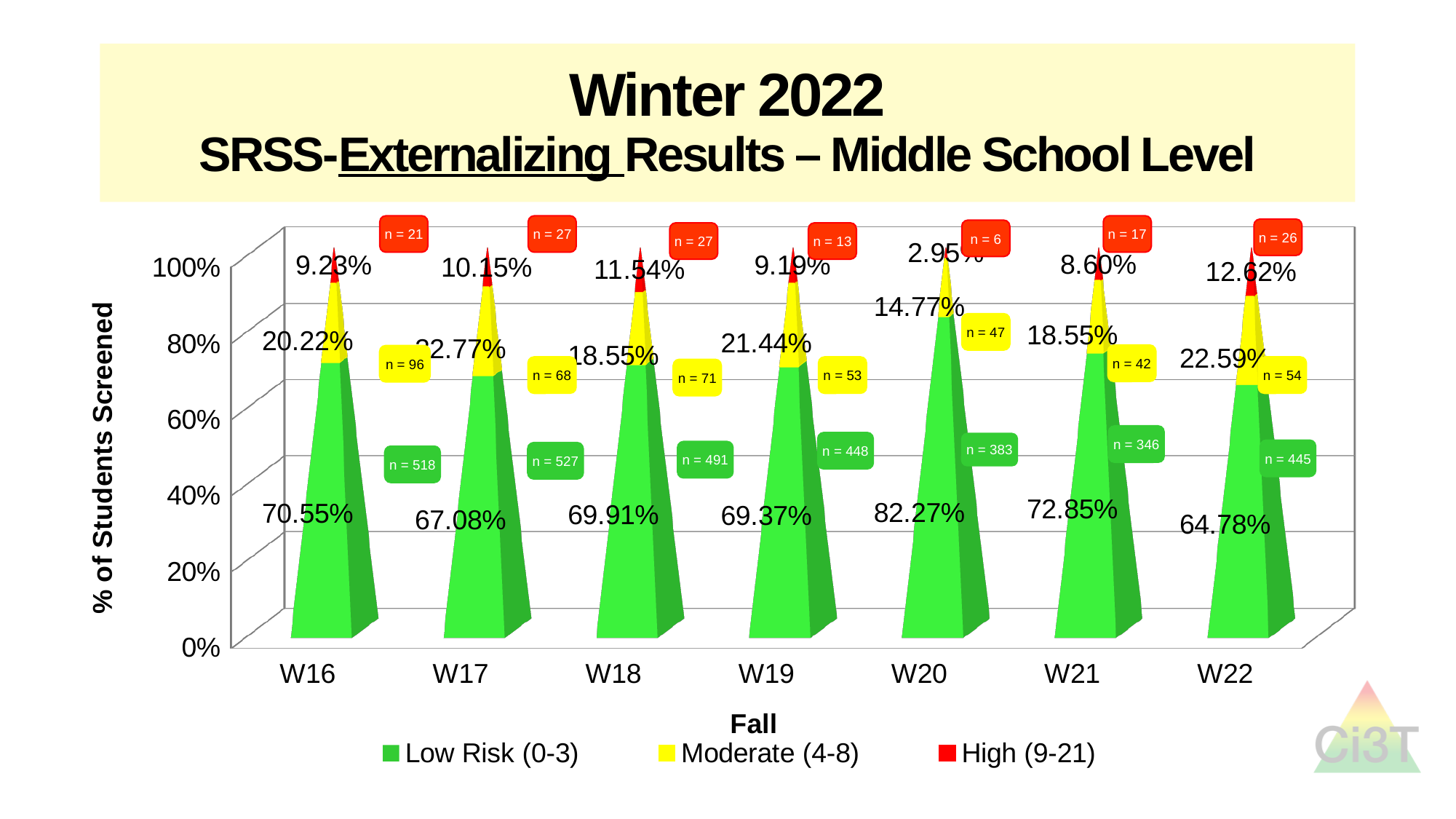
What is the n count shown for the Low Risk (0-3) group in W17? n = 527 Which is larger, the High (9-21) percentage for W18 or for W17? W18 How many series does the legend list? 3 What is the Low Risk (0-3) percentage for W20? 82.27% Which time point has the highest Low Risk (0-3) percentage? W20 What is the High (9-21) percentage for W22? 12.62% Which time point has the lowest High (9-21) percentage? W20 What kind of chart is shown on the slide? Stacked bar chart Which time point has the lowest Low Risk (0-3) percentage? W22 How many time points are shown on the x axis? 7 What is the difference between the Low Risk (0-3) percentages for W20 and W22? 17.49% What is the Moderate (4-8) percentage for W19? 21.44%